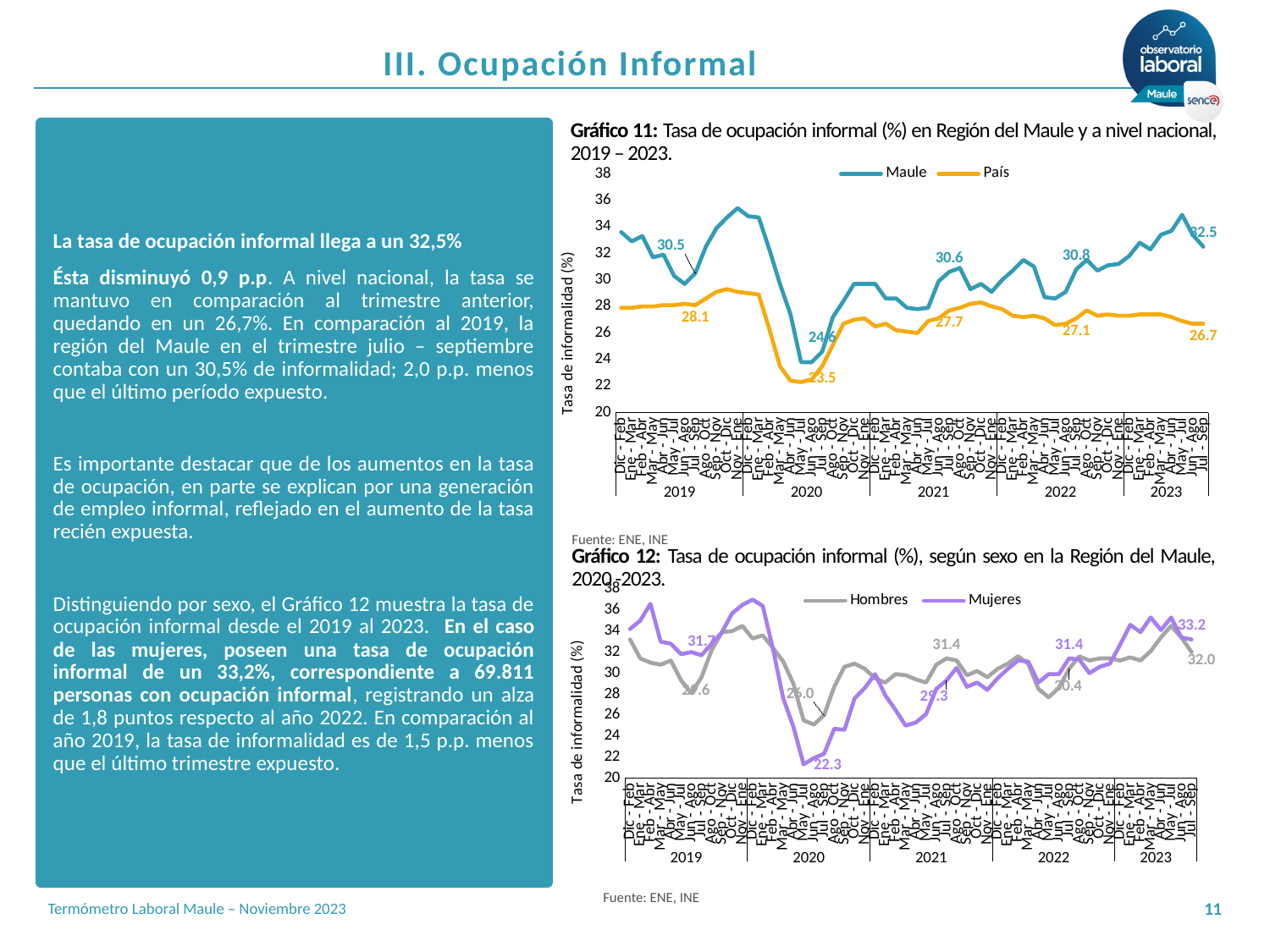
In Gráfico 11, how many series does the legend list? 2 In Gráfico 11, is the Maule value at the peak in 2019 greater or less than 34? greater In Gráfico 11, what is the latest labelled value for the Maule series (Jul - Sep 2023)? 32.5 In Gráfico 11, what is the latest labelled value for the País series (Jul - Sep 2023)? 26.7 In Gráfico 12, what is the latest labelled value for the Hombres series? 32.0 In Gráfico 11, what is the lowest labelled value shown for the País series? 23.5 In Gráfico 12, what colour is the Mujeres line? Purple In Gráfico 12, what is the latest labelled value for the Mujeres series? 33.2 In Gráfico 12, what is the lowest labelled value shown for the Mujeres series? 22.3 What type of chart is Gráfico 11? Line chart In Gráfico 11, what is the difference between the labelled Maule value 32.5 and the labelled País value 26.7 at the end of the series? 5.8 In Gráfico 12, which series has the higher labelled value at the end of the series, Hombres (32.0) or Mujeres (33.2)? Mujeres